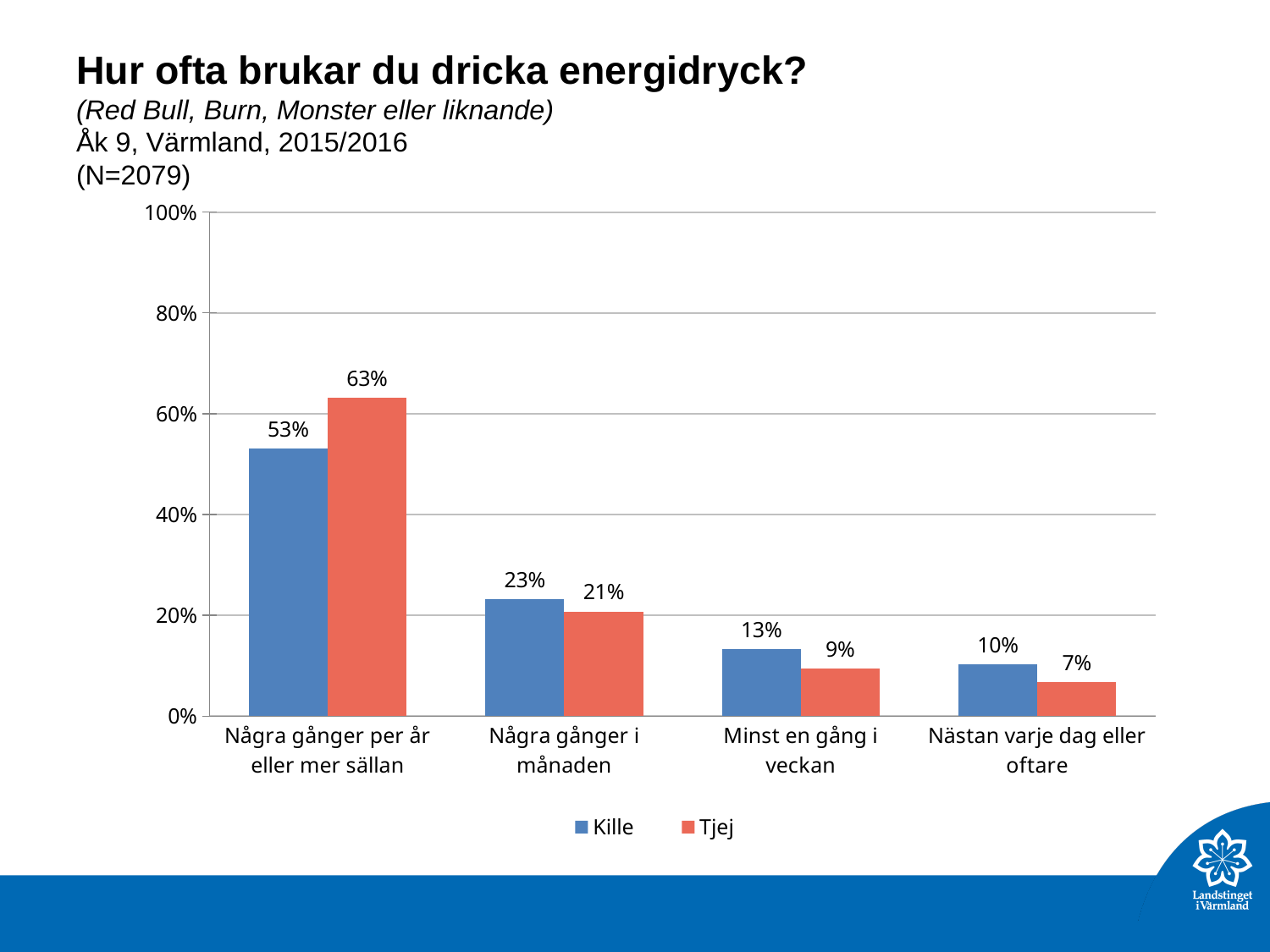
What is the value for Kille in the category "Nästan varje dag eller oftare"? 10% How many categories are shown on the x axis? 4 How many series does the legend list? 2 What is the value for Tjej in the category "Några gånger per år eller mer sällan"? 63% Which series is shown in blue in the legend? Kille In the category "Några gånger i månaden", which series has the larger value, Kille or Tjej? Kille What is the value for Kille in the category "Några gånger per år eller mer sällan"? 53% Which category has the lowest value for Kille? Nästan varje dag eller oftare What is the value for Tjej in the category "Minst en gång i veckan"? 9% What is the difference between the Tjej and Kille values in the category "Några gånger per år eller mer sällan"? 10% Which category has the highest value for Tjej? Några gånger per år eller mer sällan What kind of chart is shown on the slide? Bar chart